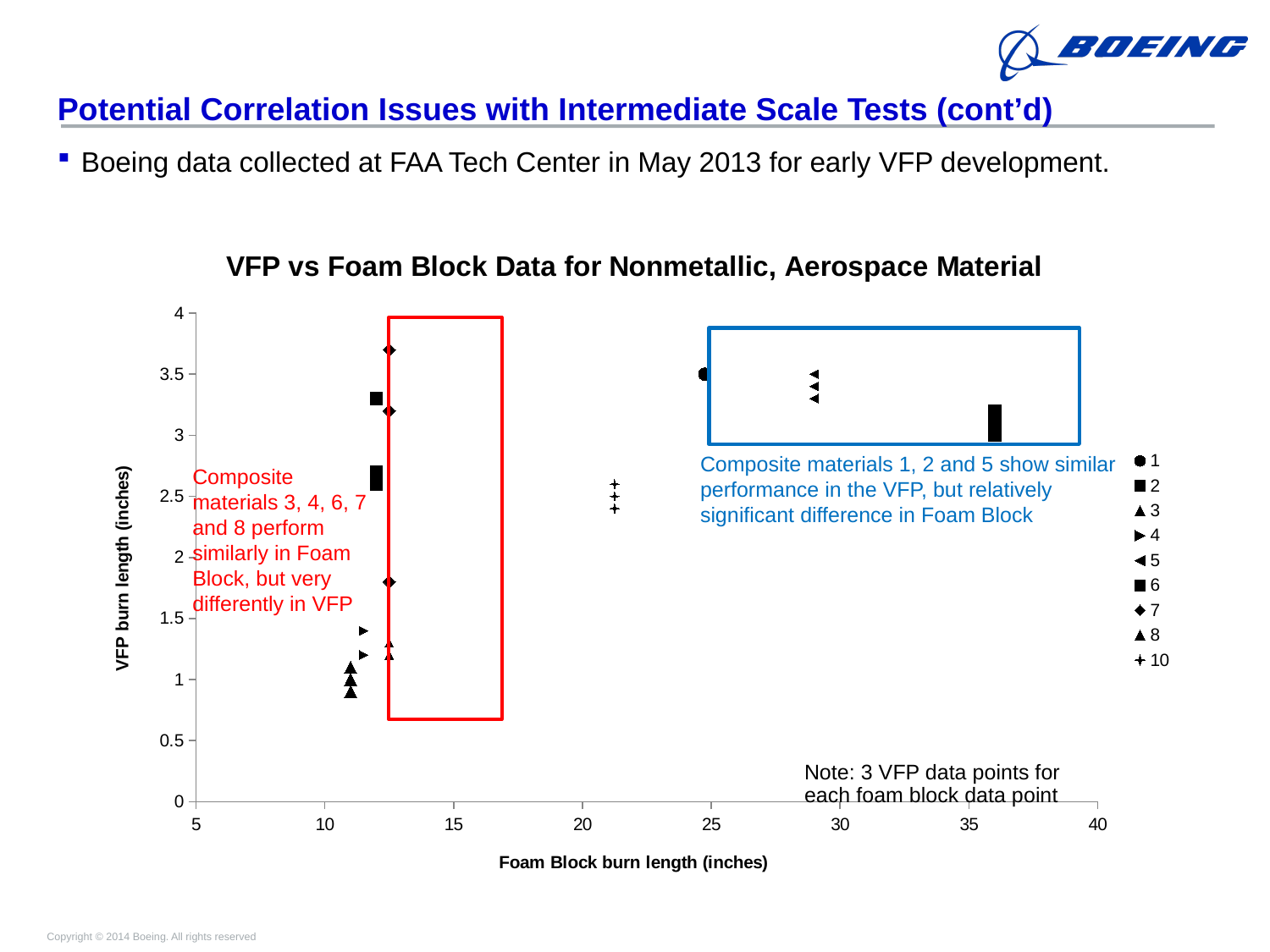
Which has the larger Foam Block burn length, series 1 or series 6? 6 Are the VFP burn length values for series 3 greater or less than 1.5? less How many series does the legend of the chart list? 9 Which series has the lowest VFP burn length? 8 What kind of chart is shown on the slide? scatter chart Is the Foam Block burn length for series 10 greater or less than 20? greater Is the Foam Block burn length for series 5 greater or less than 25? greater Which series has the largest Foam Block burn length? 6 What is the label of the x axis of the chart? Foam Block burn length (inches) What is the title of the chart? VFP vs Foam Block Data for Nonmetallic, Aerospace Material